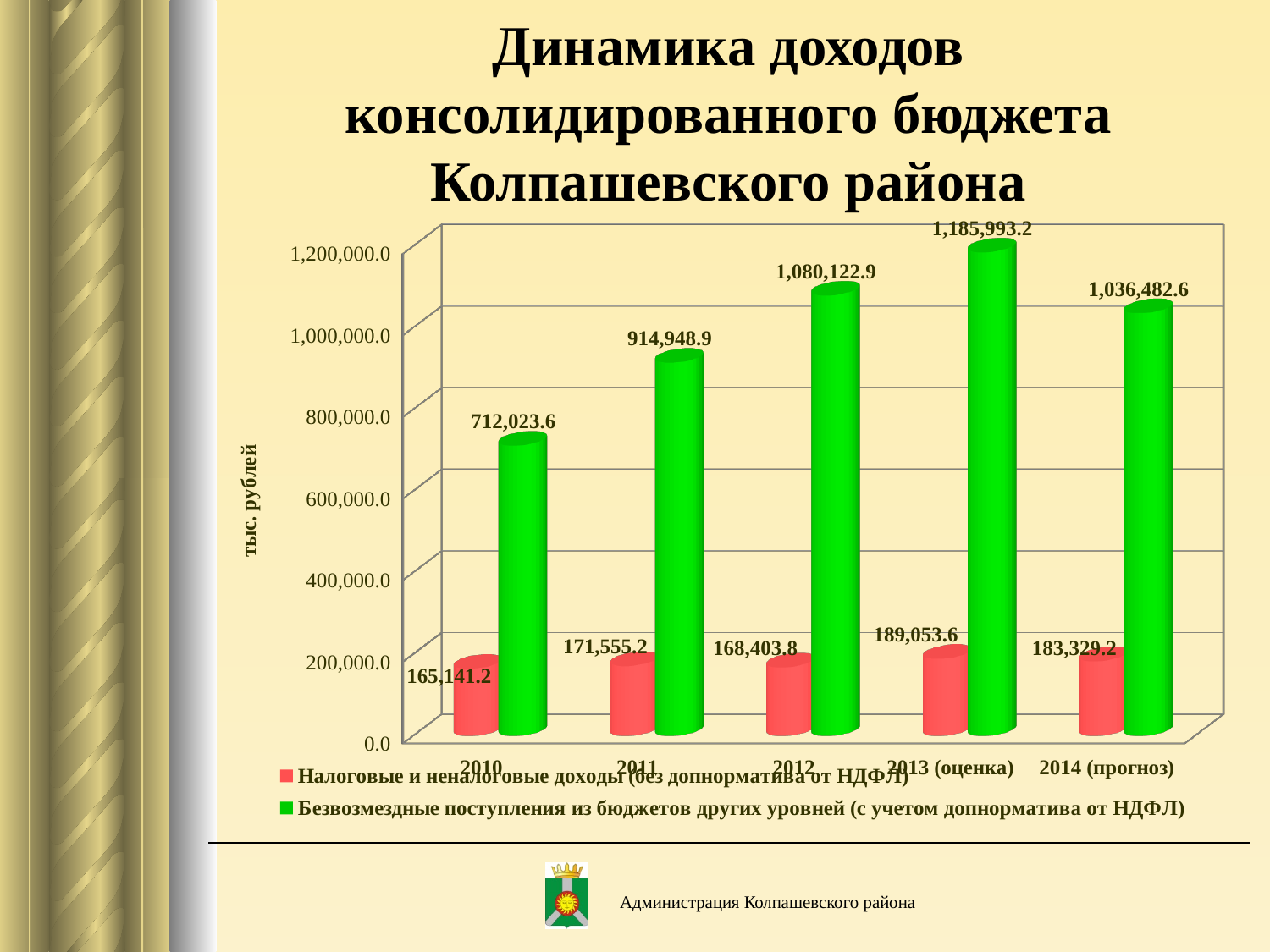
In which year is Безвозмездные поступления из бюджетов других уровней highest? 2013 (оценка) What is the value of Налоговые и неналоговые доходы for 2014 (прогноз)? 183,329.2 Is the value of Безвозмездные поступления for 2011 greater or less than 1,000,000.0? less Which is larger: Безвозмездные поступления in 2011 or in 2014 (прогноз)? 2014 (прогноз) What is the value of Налоговые и неналоговые доходы for 2010? 165,141.2 How many series does the legend list? 2 What is the value of Безвозмездные поступления из бюджетов других уровней for 2012? 1,080,122.9 How many years are shown on the x axis? 5 What is the difference between Безвозмездные поступления in 2013 (оценка) and in 2012? 105,870.3 In which year is Налоговые и неналоговые доходы lowest? 2010 What kind of chart is shown on the slide? bar chart What is the difference between Налоговые и неналоговые доходы in 2013 (оценка) and in 2010? 23,912.4